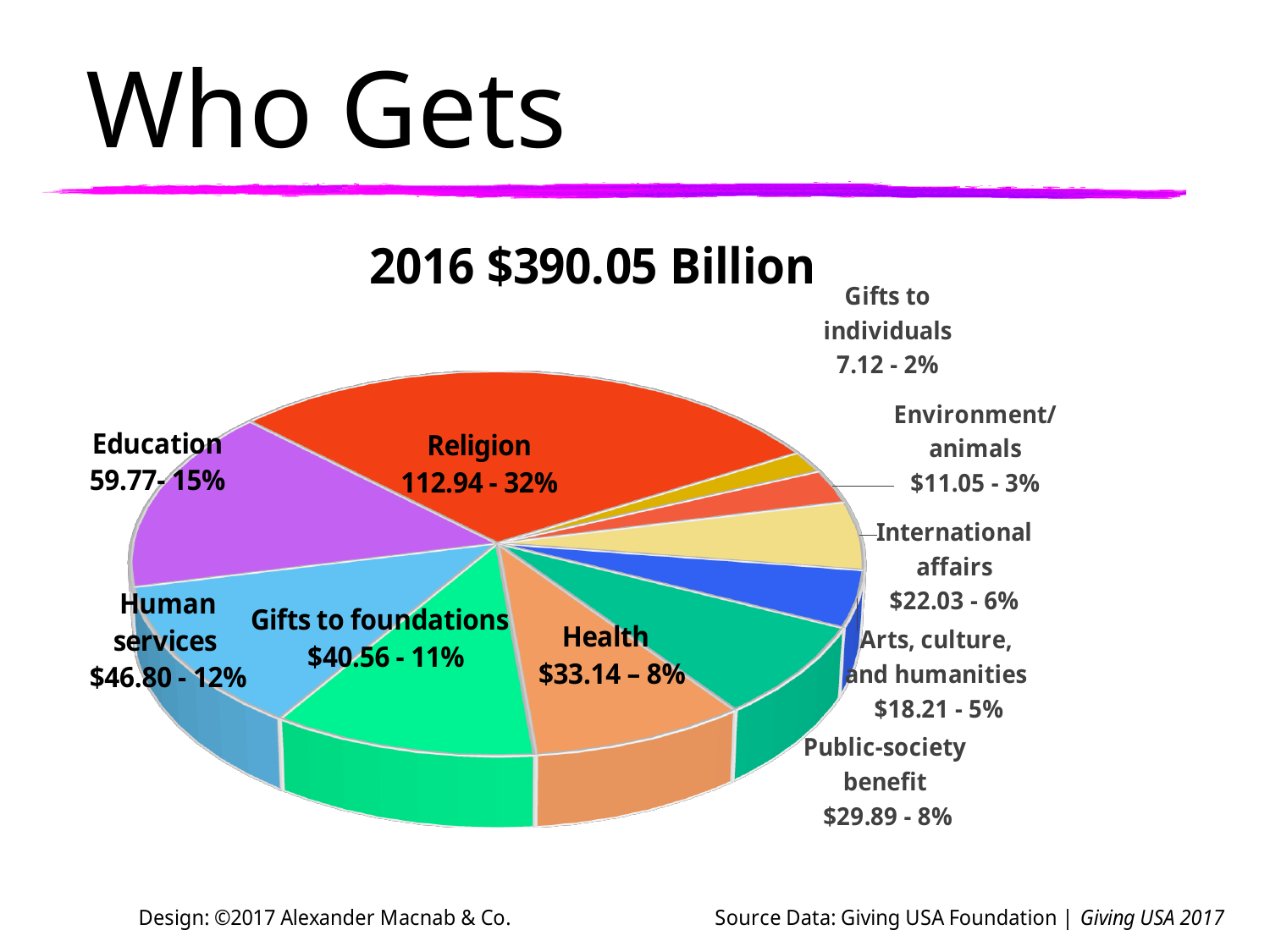
Which is larger, Gifts to foundations or Health? Gifts to foundations What share of the pie does Religion represent? 32% Which category has the smallest slice of the pie? Gifts to individuals What is the difference between the values for Health and Public-society benefit? $3.25 What is the title of the chart? 2016 $390.05 Billion What share of the pie does Education represent? 15% How many categories does the pie chart show? 10 What is the value shown for Human services? $46.80 Which category has the largest slice of the pie? Religion What kind of chart is shown on the slide? pie chart What is the value shown for International affairs? $22.03 What is the value shown for Environment/animals? $11.05